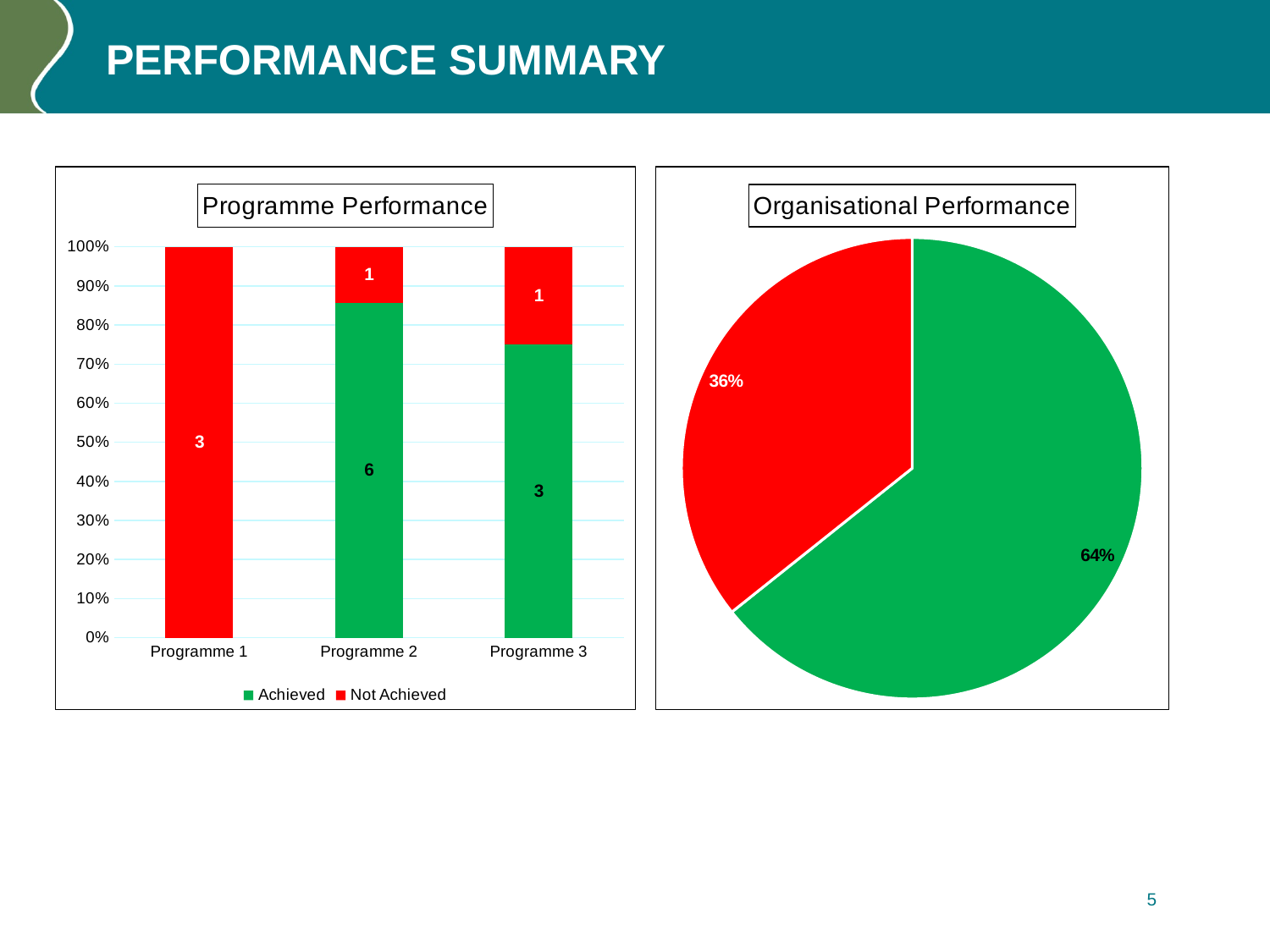
In the Organisational Performance pie chart, what share does the green slice represent? 64% In the Programme Performance chart, what is the difference between the Achieved values for Programme 2 and Programme 3? 3 In the Programme Performance chart, which programme has the highest Achieved value? Programme 2 In the Programme Performance chart, what is the Not Achieved value for Programme 3? 1 In the Programme Performance chart, what is the total of the Programme 2 bar (Achieved plus Not Achieved)? 7 In the Programme Performance chart, what is the Achieved value for Programme 2? 6 What kind of chart is the Programme Performance chart? bar chart In the Organisational Performance pie chart, what share does the red slice represent? 36% How many programmes are shown on the x axis of the Programme Performance chart? 3 What kind of chart is the Organisational Performance chart? pie chart In the Programme Performance chart, what is the Not Achieved value for Programme 1? 3 How many series does the legend of the Programme Performance chart list? 2